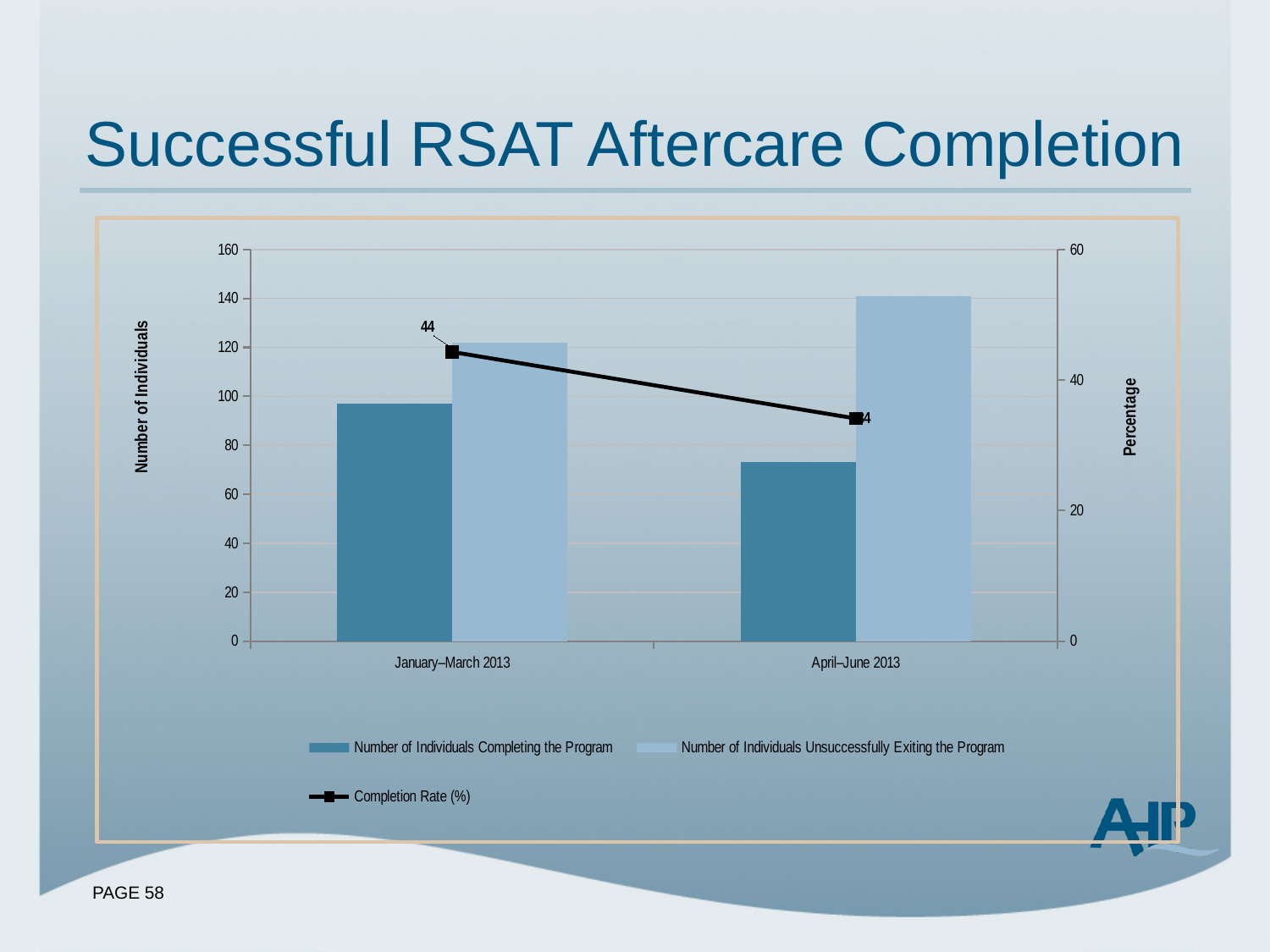
For January–March 2013, which is larger: the number completing the program or the number unsuccessfully exiting the program? Number of Individuals Unsuccessfully Exiting the Program Does the Completion Rate (%) rise or fall from January–March 2013 to April–June 2013? fall Is the Number of Individuals Completing the Program for January–March 2013 greater or less than 80? greater What is the Completion Rate (%) for January–March 2013? 44 What kind of chart is shown on the slide? Bar chart with a line How many series does the legend list? 3 Is the Number of Individuals Completing the Program for April–June 2013 greater or less than 80? less Is the Number of Individuals Unsuccessfully Exiting the Program for January–March 2013 greater or less than 100? greater Which period has the higher Number of Individuals Unsuccessfully Exiting the Program? April–June 2013 What is the title of the right-hand vertical axis? Percentage How many time periods are shown on the x axis? 2